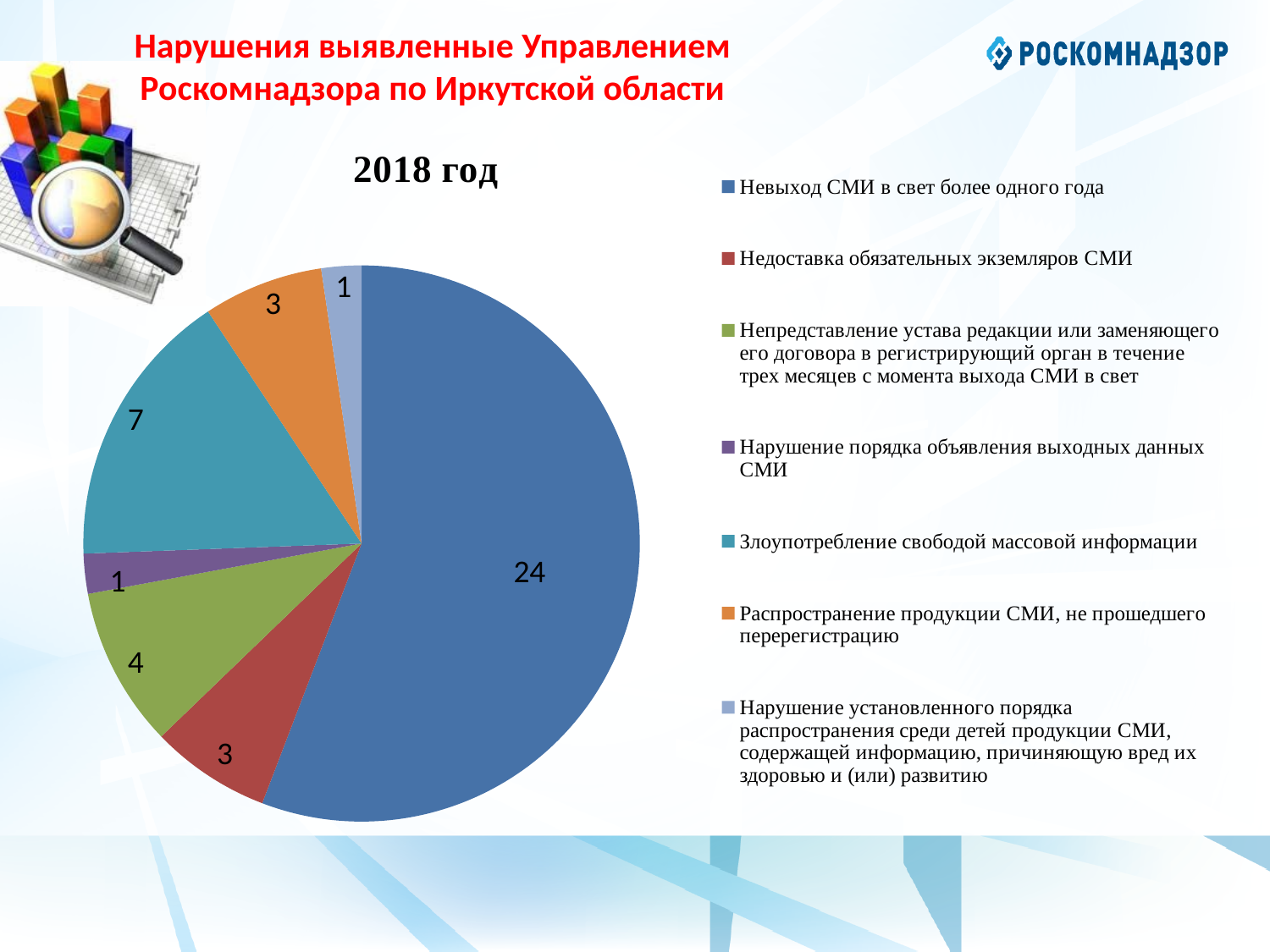
What is the value for 'Непредставление устава редакции или заменяющего его договора в регистрирующий орган в течение трех месяцев с момента выхода СМИ в свет'? 4 What is the value for 'Нарушение порядка объявления выходных данных СМИ'? 1 What is the value for 'Невыход СМИ в свет более одного года'? 24 What is the difference between the value for 'Невыход СМИ в свет более одного года' and the value for 'Злоупотребление свободой массовой информации'? 17 Which category has the largest slice of the pie? Невыход СМИ в свет более одного года How many slices does the pie chart have? 7 Which is larger: the value for 'Злоупотребление свободой массовой информации' or the value for 'Недоставка обязательных экземляров СМИ'? Злоупотребление свободой массовой информации What is the value for 'Злоупотребление свободой массовой информации'? 7 How many entries does the legend list? 7 What is the total of all slices in the pie chart? 43 What kind of chart is shown on the slide? pie chart What is the title of the chart? 2018 год